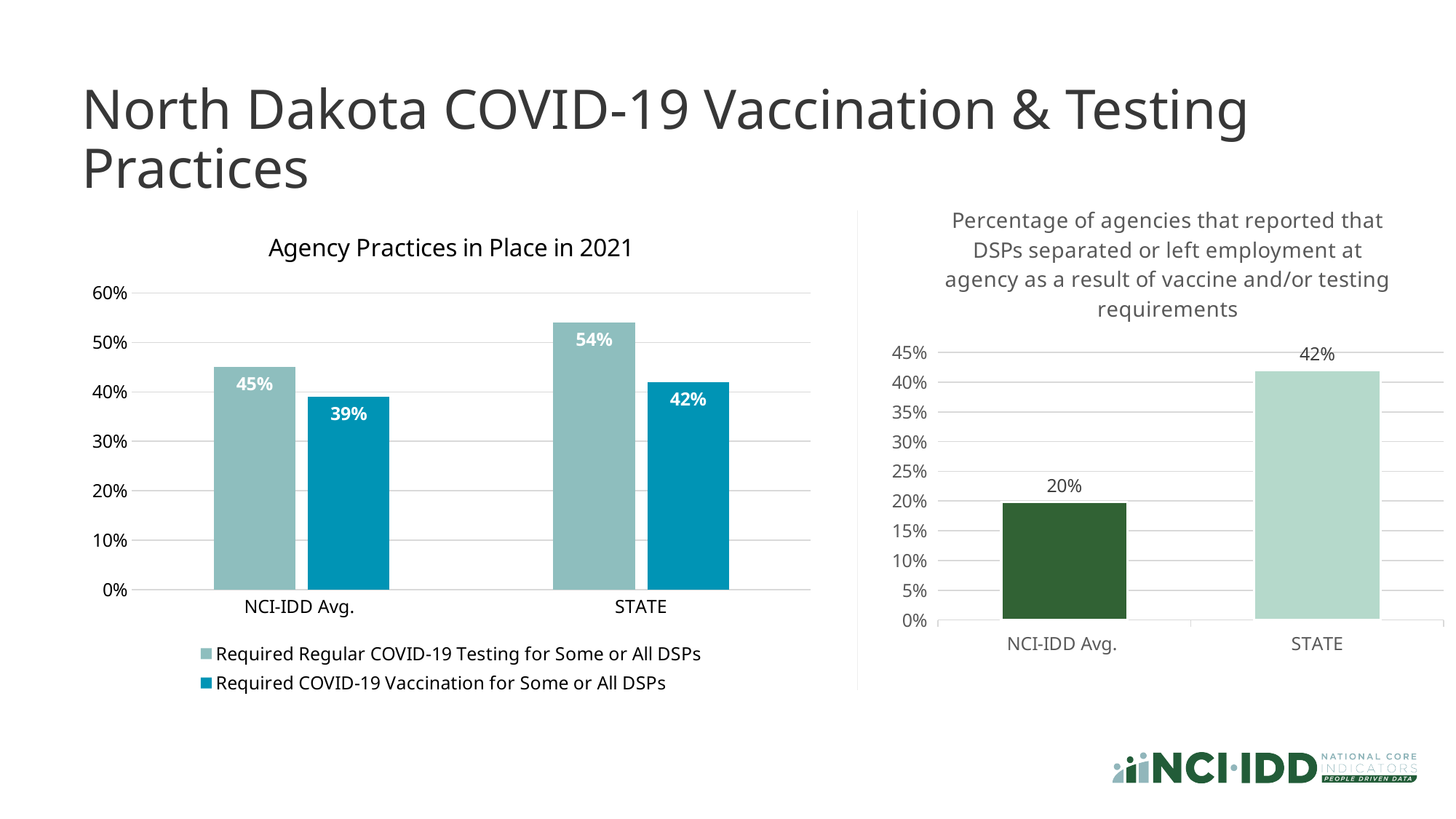
In the chart on the right about DSPs separating or leaving employment, what is the value for STATE? 42% In the chart on the right about DSPs separating or leaving employment, what is the value for NCI-IDD Avg.? 20% In the 'Agency Practices in Place in 2021' chart, how many series does the legend list? 2 In the 'Agency Practices in Place in 2021' chart, what is the value for Required COVID-19 Vaccination for Some or All DSPs for NCI-IDD Avg.? 39% In the 'Agency Practices in Place in 2021' chart, what is the value for Required Regular COVID-19 Testing for Some or All DSPs for STATE? 54% In the chart on the right about DSPs separating or leaving employment, which category has the highest value? STATE In the 'Agency Practices in Place in 2021' chart, what is the difference between the STATE and NCI-IDD Avg. values for Required Regular COVID-19 Testing for Some or All DSPs? 9% In the chart on the right about DSPs separating or leaving employment, what is the difference between STATE and NCI-IDD Avg.? 22% In the 'Agency Practices in Place in 2021' chart, which bar has the lowest value? Required COVID-19 Vaccination for Some or All DSPs for NCI-IDD Avg. In the 'Agency Practices in Place in 2021' chart, which is larger for STATE: Required Regular COVID-19 Testing or Required COVID-19 Vaccination? Required Regular COVID-19 Testing for Some or All DSPs What kind of chart is the 'Agency Practices in Place in 2021' chart? Bar chart In the chart on the right about DSPs separating or leaving employment, how many categories are shown? 2